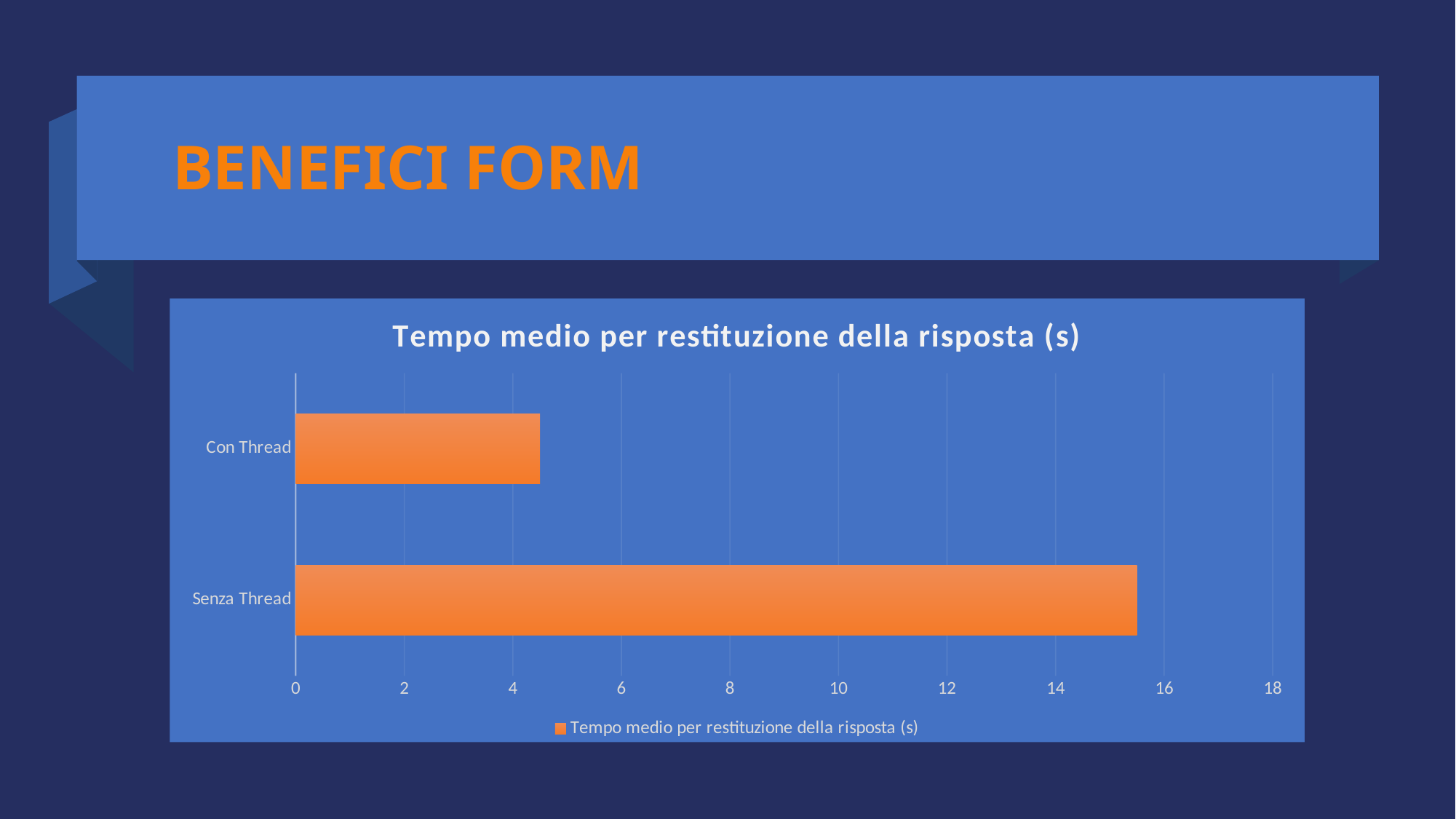
What is the highest value shown on the horizontal axis of the chart? 18 What kind of chart is shown on the slide? bar chart Which is larger, the value for Con Thread or the value for Senza Thread? Senza Thread Which category has the highest value? Senza Thread How many categories are plotted in the chart? 2 Is the value for Senza Thread greater or less than 16? less Is the value for Con Thread greater or less than 4? greater Which category has the lowest value? Con Thread What is the title of the chart? Tempo medio per restituzione della risposta (s) Is the value for Senza Thread greater or less than 14? greater How many series does the legend list? 1